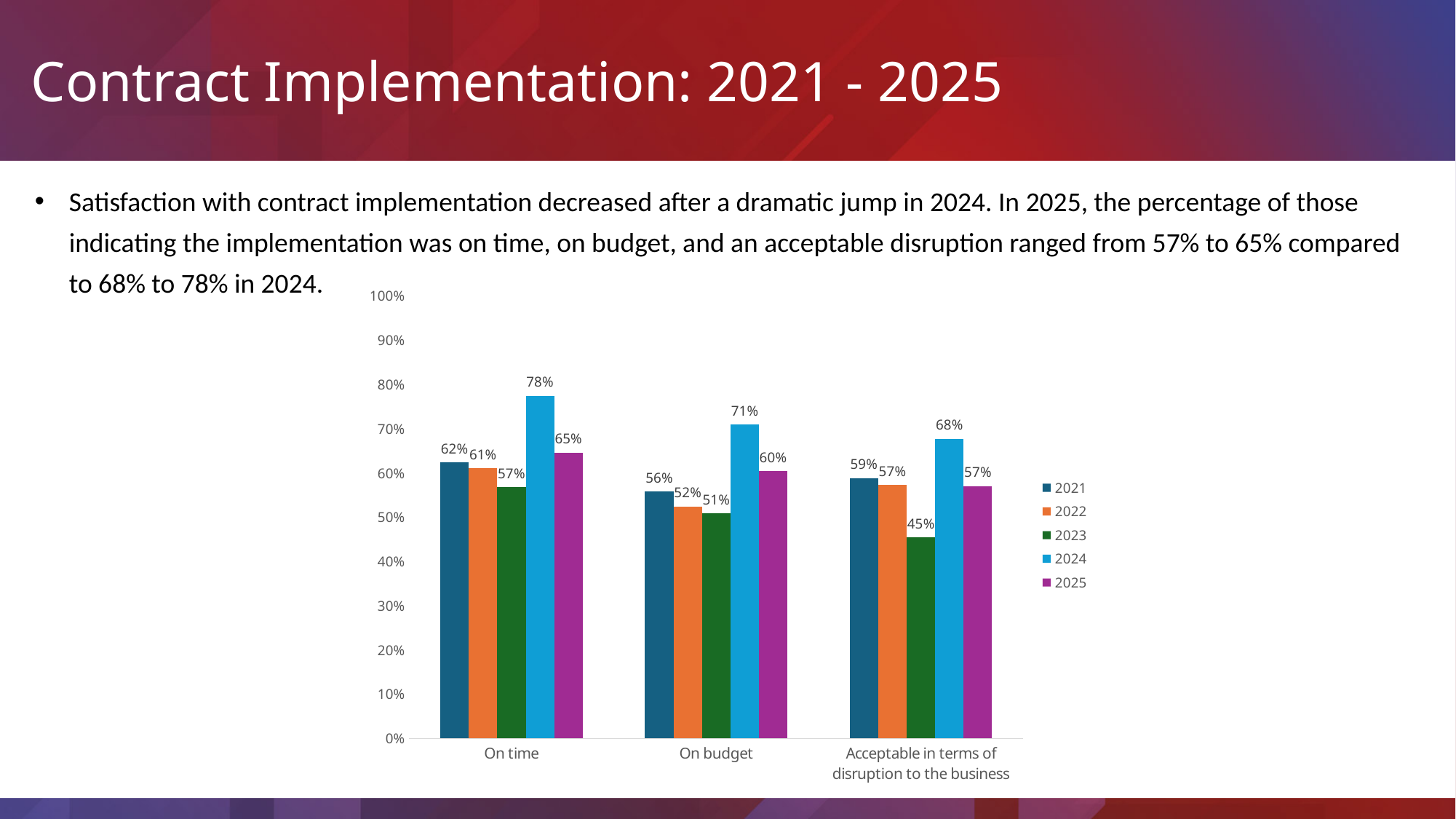
Which colour represents 2024 in the legend? light blue How many series does the legend list? 5 What is the value for 2024 in the On time category? 78% What kind of chart is shown on the slide? bar chart What is the value for 2025 in the Acceptable in terms of disruption to the business category? 57% Which is larger: the 2021 value for On budget or the 2021 value for Acceptable in terms of disruption to the business? Acceptable in terms of disruption to the business How many categories are shown on the x axis? 3 Which year has the highest value in the On budget category? 2024 What is the value for 2023 in the On budget category? 51% Is the 2023 value for Acceptable in terms of disruption to the business greater or less than 50%? less What is the difference between the 2024 and 2025 values in the On time category? 13% Which year has the lowest value in the Acceptable in terms of disruption to the business category? 2023